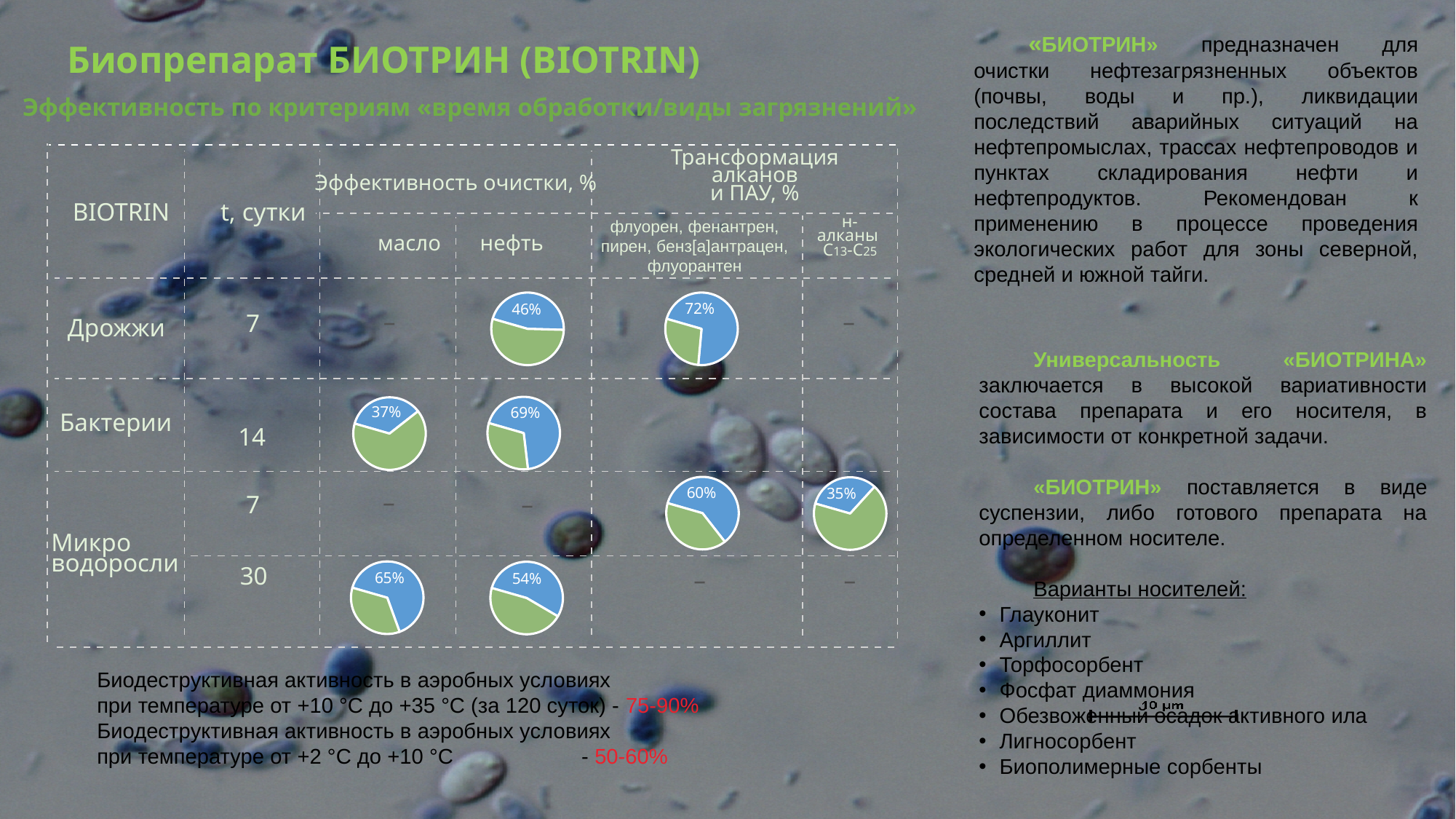
Which is larger: the масло efficiency for Микроводоросли at 30 суток or the масло efficiency for Бактерии? Микроводоросли at 30 суток (65%) In the table of pie charts, what cleaning efficiency is shown for Дрожжи (yeast) on нефть (oil)? 46% In the table of pie charts, what cleaning efficiency is shown for Бактерии on нефть? 69% In the table of pie charts, what cleaning efficiency is shown for Микроводоросли at 30 суток on нефть? 54% What type of charts are used in the table to show the percentages? Pie charts In the table of pie charts, what value is shown for Микроводоросли at 7 суток in the н-алканы C13-C25 column? 35% Which pie chart in the table shows the lowest percentage? Микроводоросли, 7 суток, н-алканы C13-C25 (35%) In the table of pie charts, what cleaning efficiency is shown for Микроводоросли at 30 суток on масло? 65% In the table of pie charts, what value is shown for Дрожжи in the флуорен, фенантрен, пирен, бенз[а]антрацен, флуорантен column? 72% In the table of pie charts, what cleaning efficiency is shown for Бактерии (bacteria) on масло? 37% What is the difference between the нефть efficiency for Бактерии and the нефть efficiency for Дрожжи? 23% Which pie chart in the table shows the highest percentage? Дрожжи, флуорен/фенантрен/пирен/бенз[а]антрацен/флуорантен (72%)